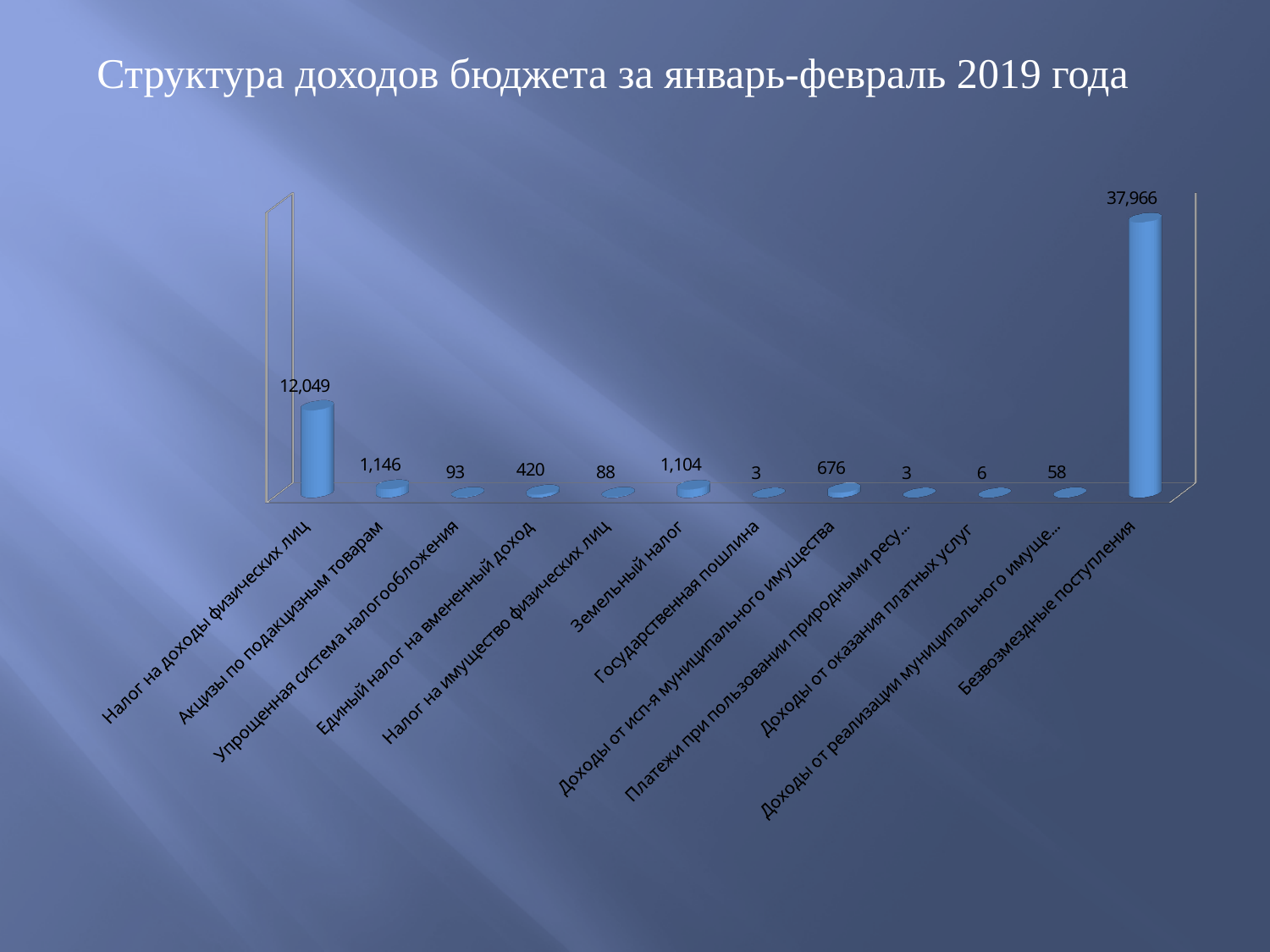
What is the title of the slide? Структура доходов бюджета за январь-февраль 2019 года What is the value for Земельный налог? 1,104 What is the value for Безвозмездные поступления? 37,966 What is the difference between Безвозмездные поступления and Налог на доходы физических лиц? 25,917 How many categories are shown in the chart? 12 Which is larger, Упрощенная система налогообложения or Налог на имущество физических лиц? Упрощенная система налогообложения What is the value for Государственная пошлина? 3 What kind of chart is shown on the slide? Bar chart What is the value for Налог на доходы физических лиц? 12,049 What is the value for Единый налог на вмененный доход? 420 Which category has the highest value? Безвозмездные поступления What is the difference between Акцизы по подакцизным товарам and Земельный налог? 42